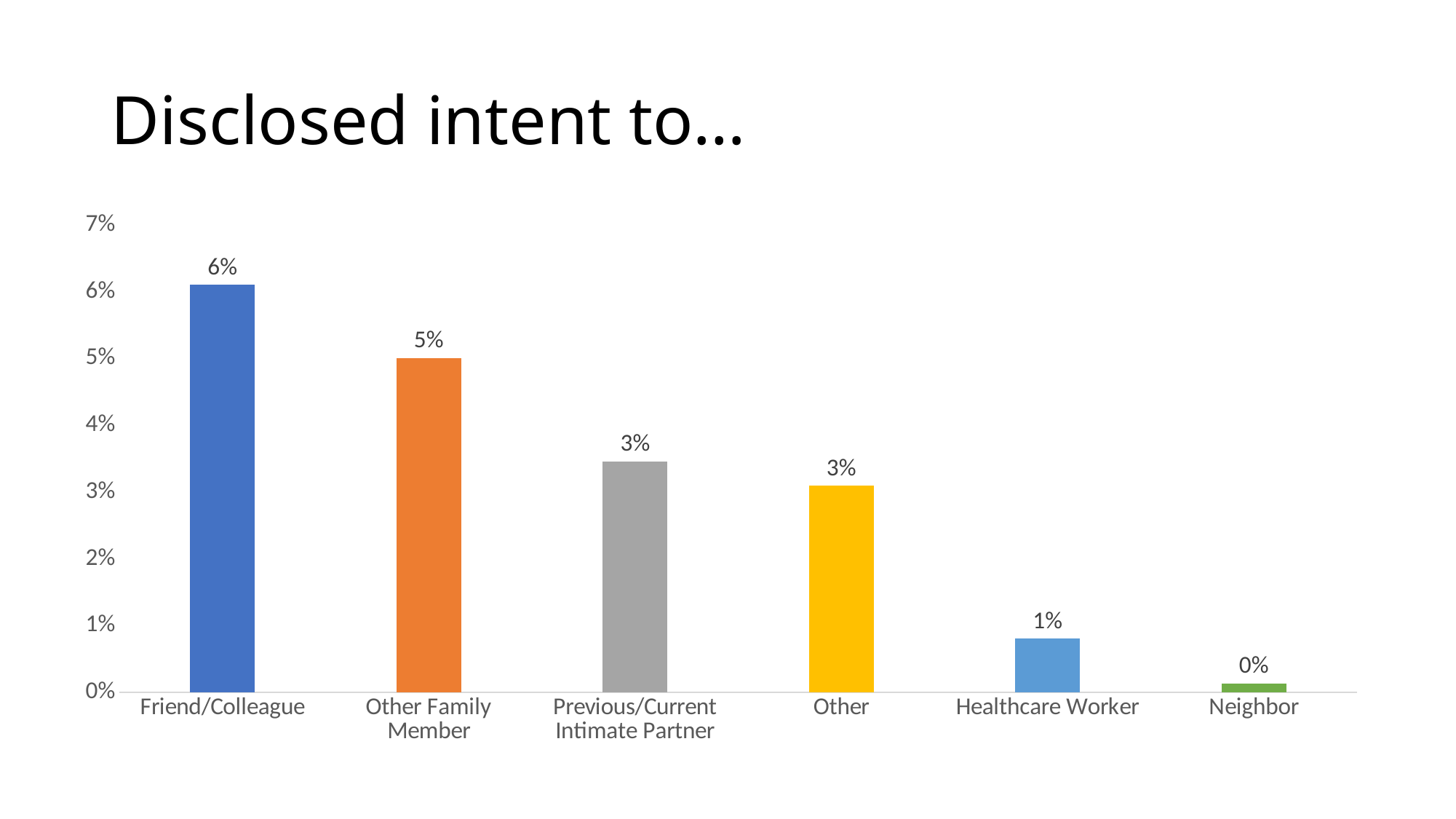
What is the title of the slide? Disclosed intent to… Which category has the highest value? Friend/Colleague How many categories are shown on the x axis? 6 What is the value for Healthcare Worker? 1% Which category has the lowest value? Neighbor What kind of chart is shown on the slide? bar chart What is the value for Other Family Member? 5% What is the value for Friend/Colleague? 6% Which is larger, the value for Other Family Member or the value for Healthcare Worker? Other Family Member What is the value for Neighbor? 0% What is the difference between the values for Friend/Colleague and Other Family Member? 1% Is the value for Previous/Current Intimate Partner greater or less than 4%? less